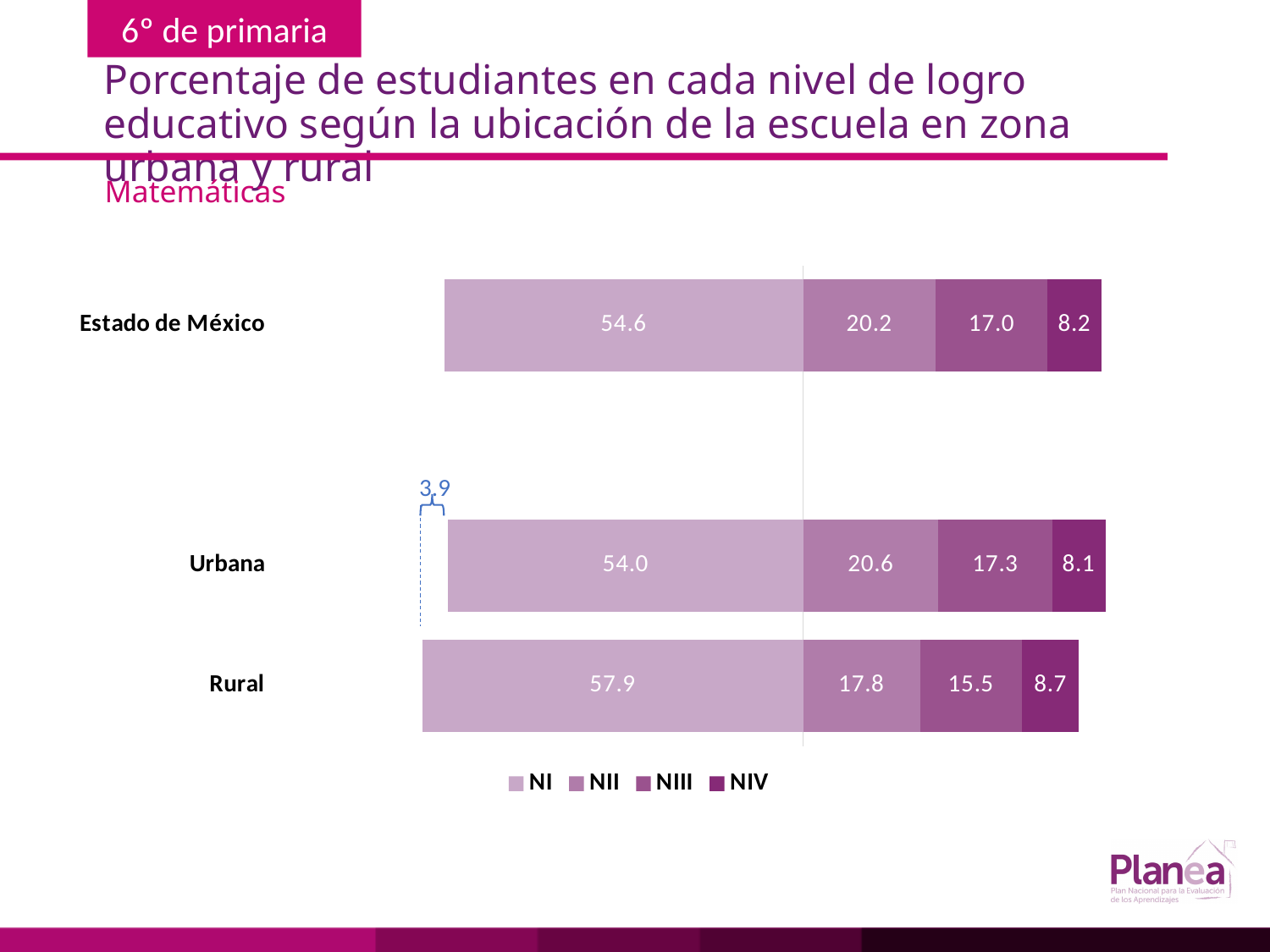
What is the NIV value for Rural schools? 8.7 Which category has the lowest NIII value? Rural What percentage of students in Estado de México are at level NI? 54.6 What is the difference between the NI values for Rural and Urbana schools? 3.9 Which category has the highest NI value? Rural What kind of chart is shown on the slide? Stacked bar chart Which is larger, the NIV value for Urbana or for Rural? Rural What is the NII value for Rural schools? 17.8 How many series does the legend list? 4 What is the NIII value for Urbana schools? 17.3 How many categories are shown on the chart? 3 What is the difference between the NII values for Urbana and Rural schools? 2.8